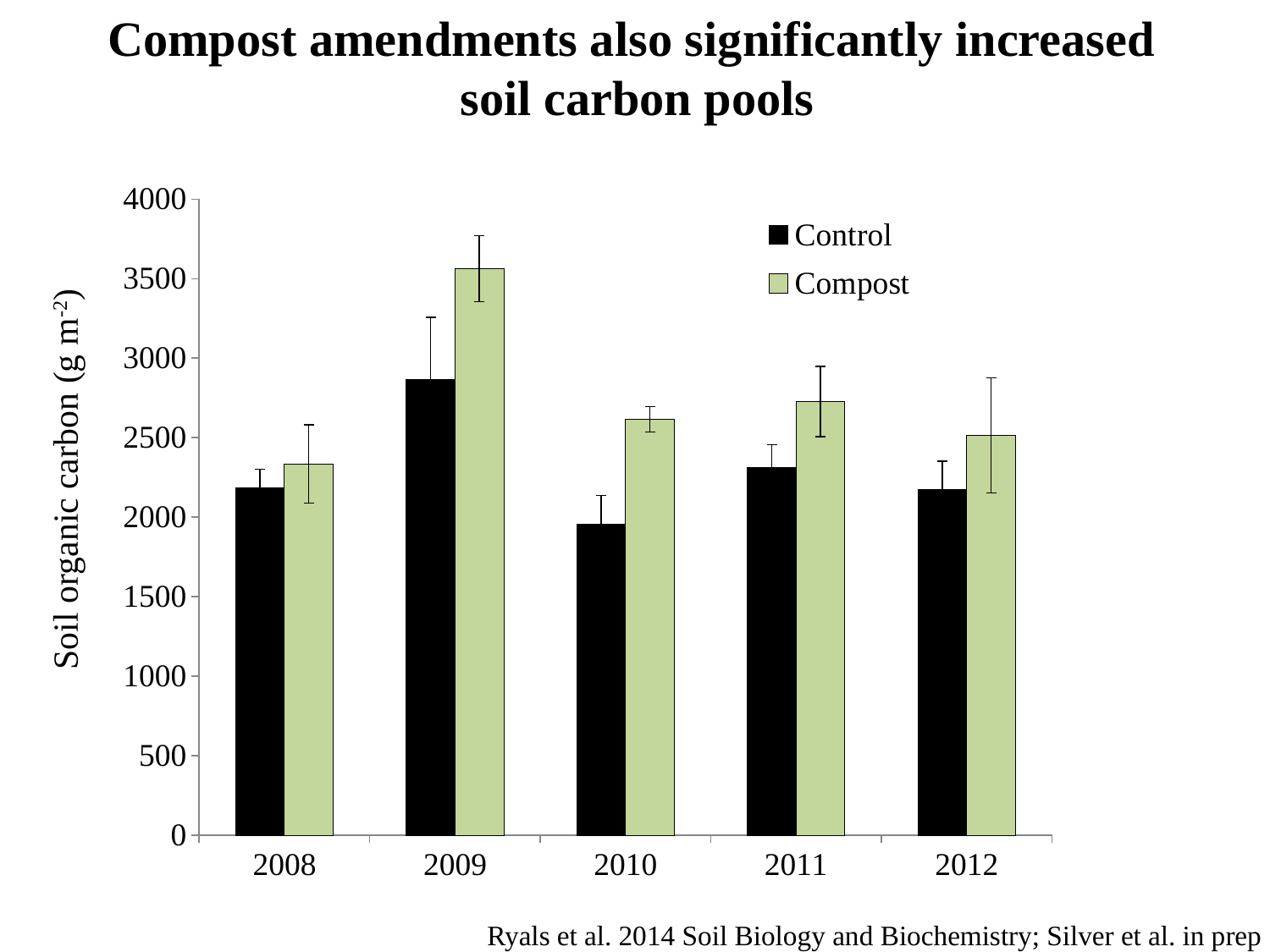
In which year is the Control soil organic carbon highest? 2009 In which year is the Control soil organic carbon lowest? 2010 Is the Compost value for 2010 greater or less than 2500? greater What kind of chart is shown on the slide? bar chart Is the Compost value for 2009 greater or less than 3000? greater What is the label on the y axis? Soil organic carbon (g m-2) How many series does the legend list? 2 In which year is the Compost soil organic carbon highest? 2009 Which series is shown with black bars? Control How many years are shown on the x axis? 5 Which is larger in 2009, the Control bar or the Compost bar? Compost